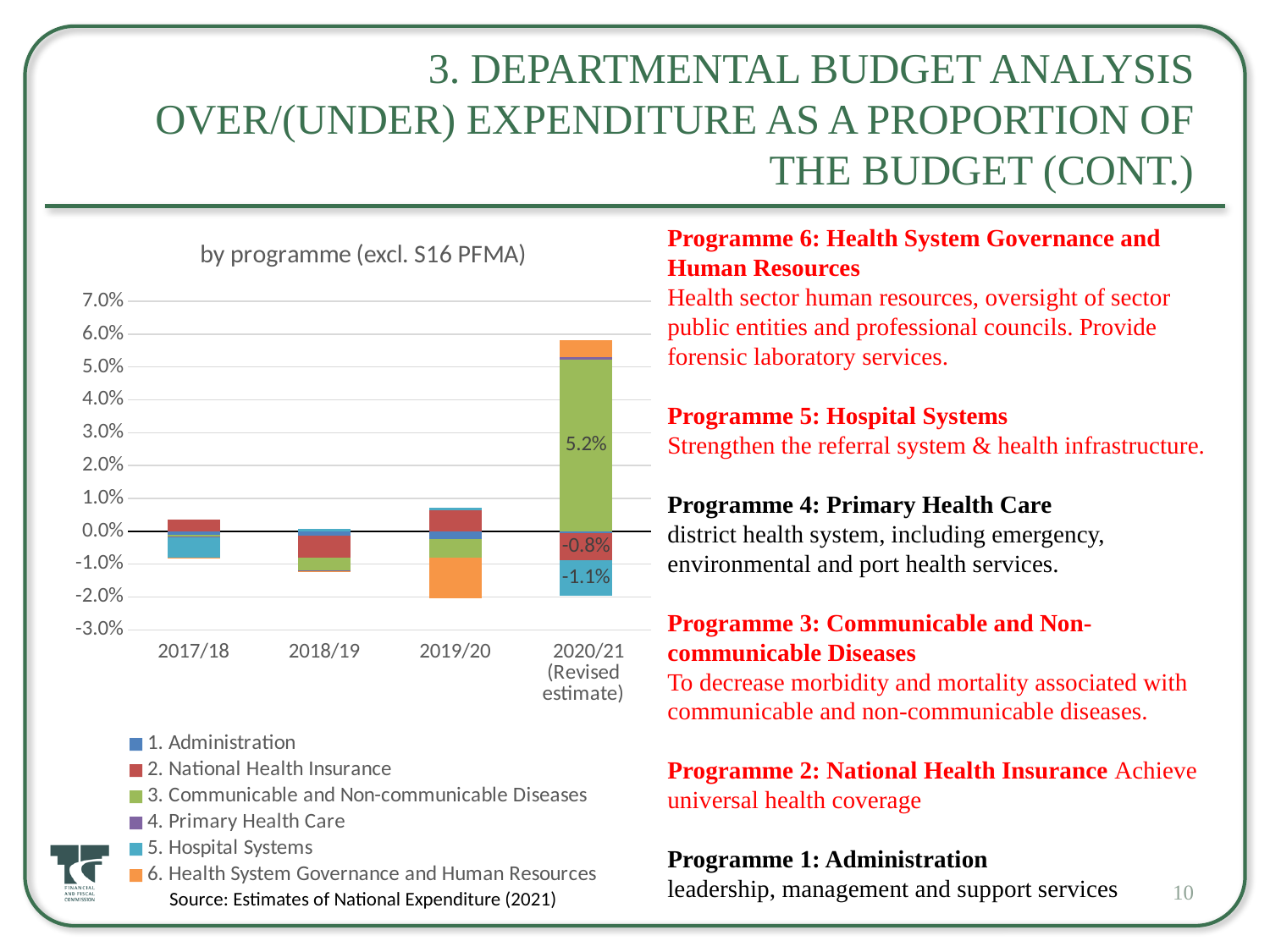
What is the value for 5. Hospital Systems in 2020/21 (Revised estimate)? -1.1% In 2020/21 (Revised estimate), which is larger: the value for 3. Communicable and Non-communicable Diseases or the value for 2. National Health Insurance? 3. Communicable and Non-communicable Diseases How many years are shown on the x axis of the chart? 4 What is the value for 2. National Health Insurance in 2020/21 (Revised estimate)? -0.8% Which year has the tallest positive stacked bar? 2020/21 (Revised estimate) How many series does the chart legend list? 6 Which series has the largest value in 2020/21 (Revised estimate)? 3. Communicable and Non-communicable Diseases What is the value for 3. Communicable and Non-communicable Diseases in 2020/21 (Revised estimate)? 5.2% What kind of chart is shown on the slide? Stacked bar chart Is the value for 3. Communicable and Non-communicable Diseases in 2020/21 (Revised estimate) greater or less than 4.0%? greater What is the difference between the 2020/21 (Revised estimate) values for 2. National Health Insurance (-0.8%) and 5. Hospital Systems (-1.1%)? 0.3 percentage points What is the title of the chart? by programme (excl. S16 PFMA)